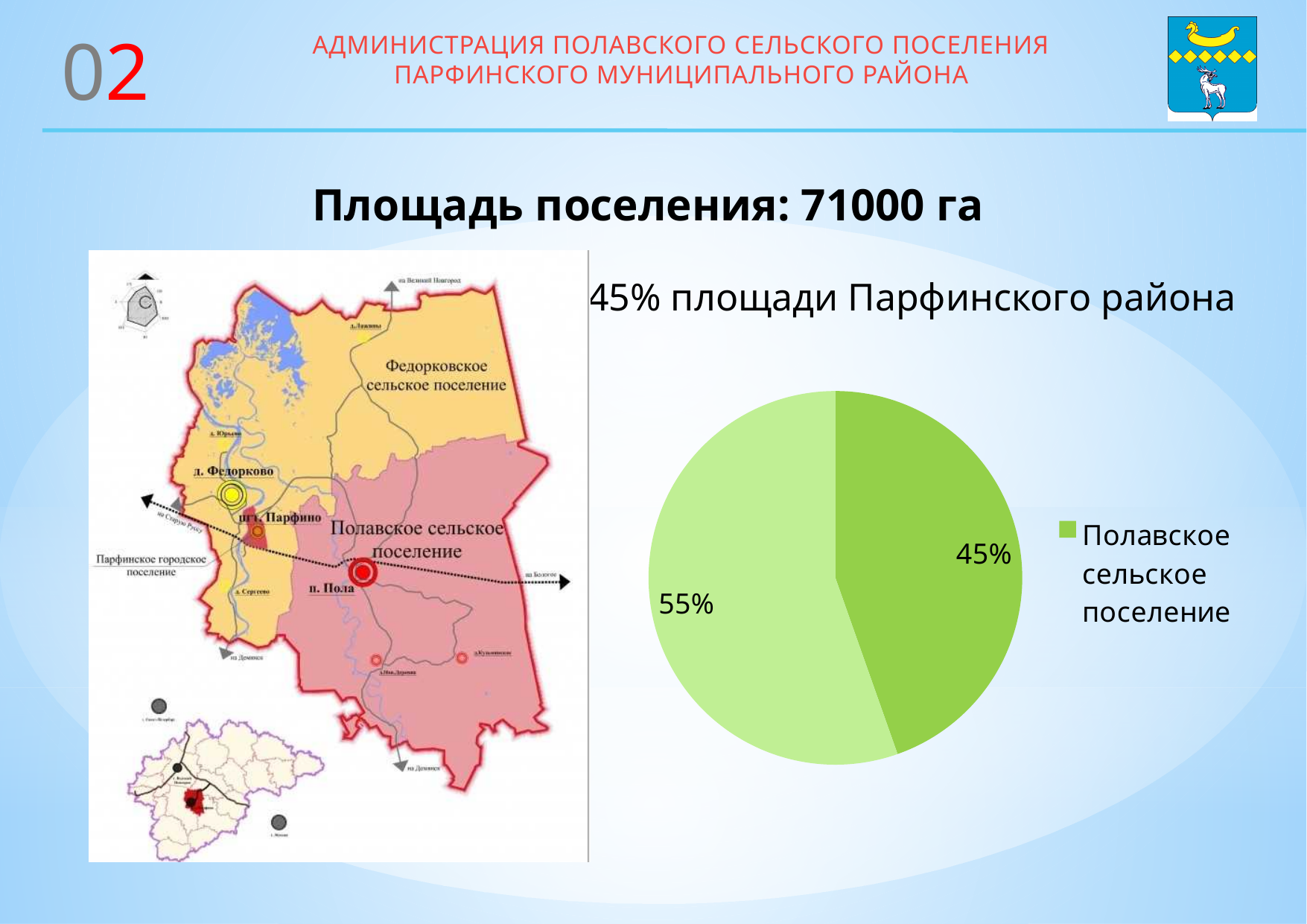
What is the total of the two slices shown in the pie chart? 100% What is the only entry listed in the pie chart's legend? Полавское сельское поселение What is the difference in percentage points between the two slices of the pie chart? 10% What share of the pie does the slice labelled "Полавское сельское поселение" represent? 45% How many slices does the pie chart have? 2 What text appears above the pie chart describing what the 45% share refers to? 45% площади Парфинского района Which slice of the pie chart is the smallest? Полавское сельское поселение (45%) How many entries does the legend of the pie chart list? 1 What kind of chart is shown on the slide? pie chart What percentage is shown on the larger, lighter green slice of the pie chart? 55% Which slice of the pie chart is larger, the 45% slice or the 55% slice? the 55% slice Is the share for "Полавское сельское поселение" greater or less than 50%? less